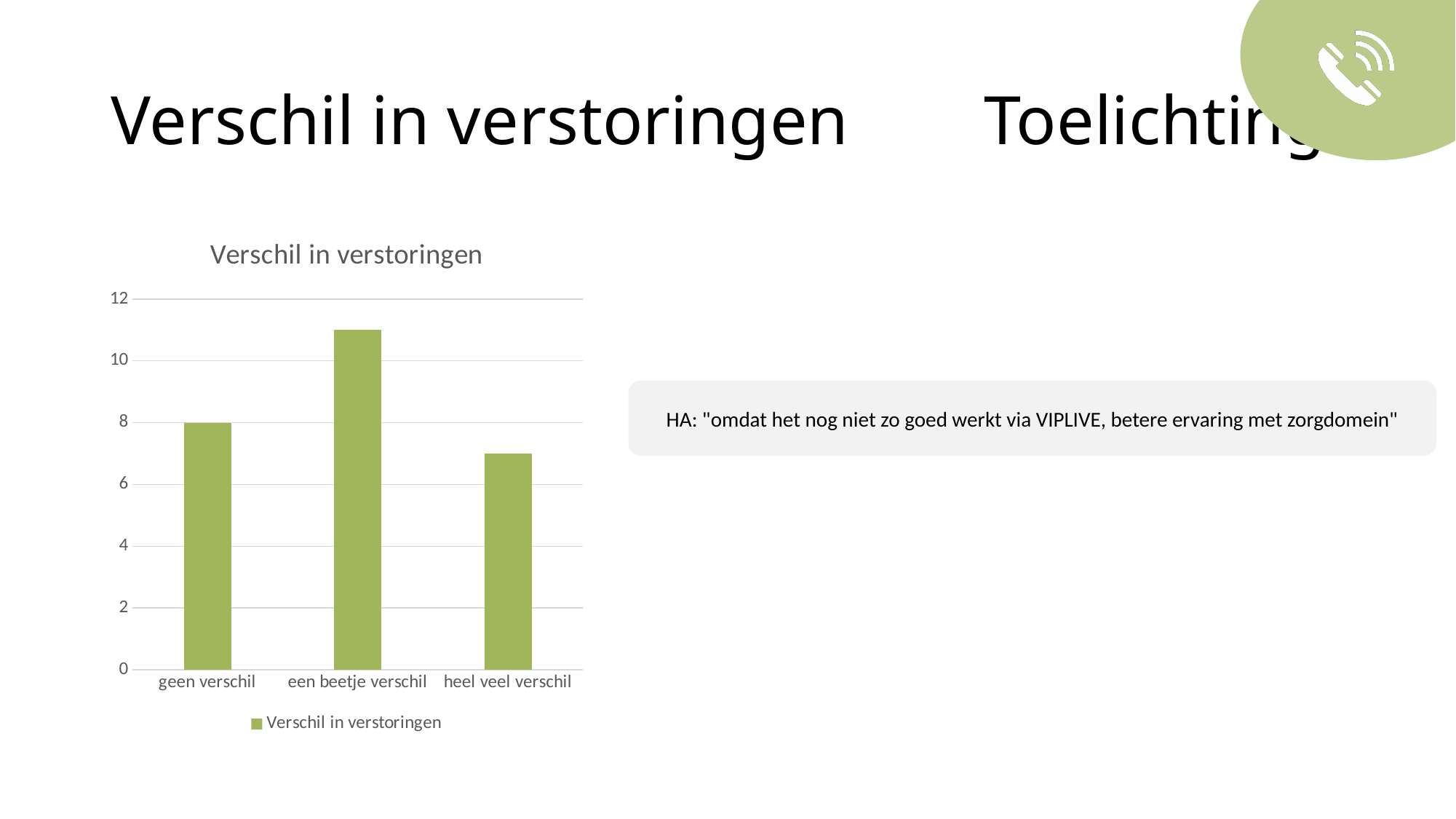
Which category has the highest value? een beetje verschil What is the value for 'geen verschil'? 8 Is the value for 'een beetje verschil' greater or less than 10? greater Which category has the lowest value? heel veel verschil What is the name of the series shown in the chart legend? Verschil in verstoringen What type of chart is shown on the slide? bar chart Is the value for 'een beetje verschil' greater or less than 12? less What is the title of the chart? Verschil in verstoringen How many categories are shown on the x axis of the chart? 3 Is the value for 'heel veel verschil' greater or less than 8? less How many series does the chart legend list? 1 Which is larger, the value for 'geen verschil' or the value for 'heel veel verschil'? geen verschil